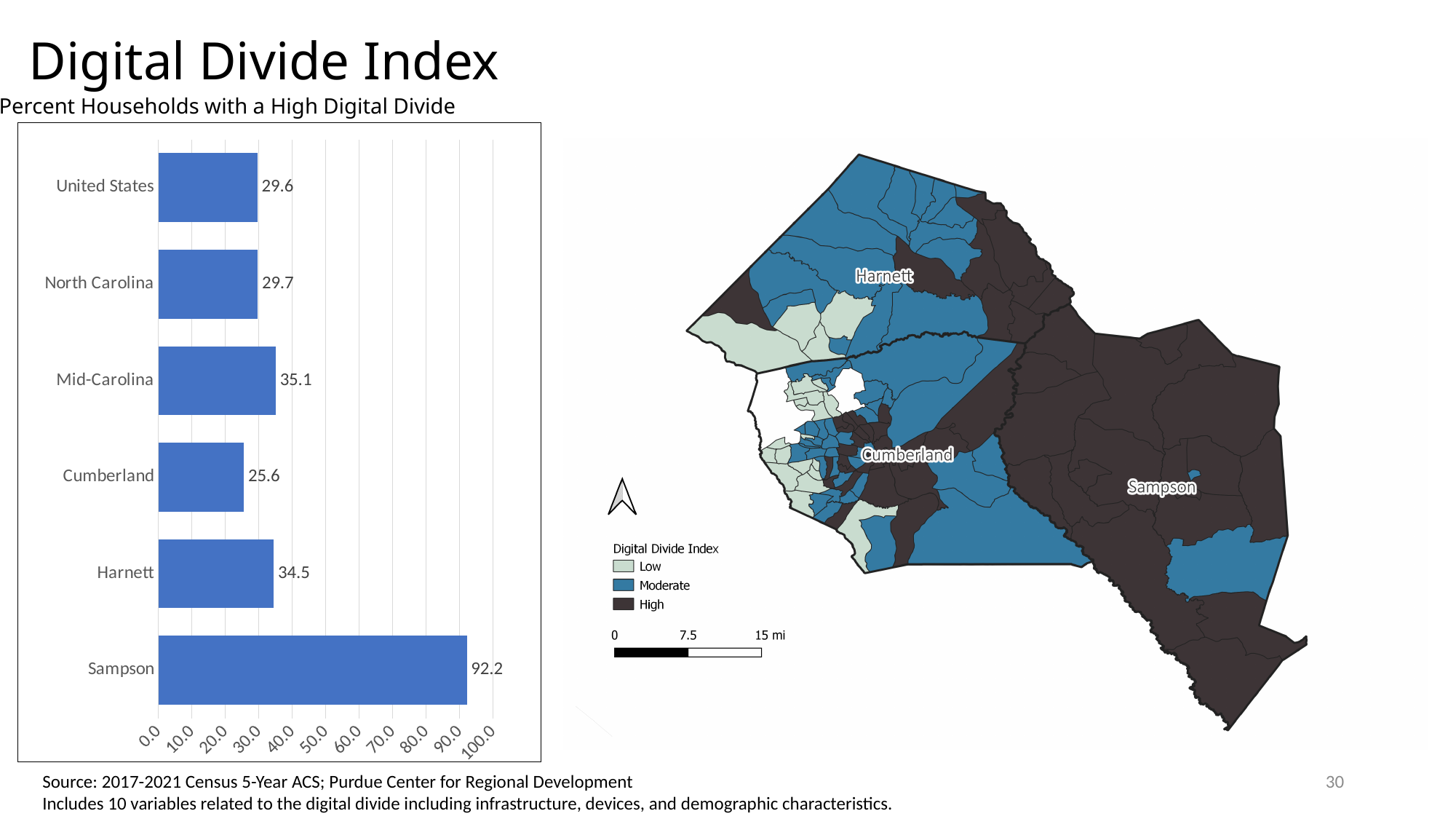
Which is larger in the bar chart, the value for Harnett or the value for Cumberland? Harnett What is the difference between the values for Sampson and Cumberland in the bar chart? 66.6 What are the three categories listed in the map legend for the Digital Divide Index? Low, Moderate, High Which category has the lowest value in the bar chart? Cumberland What is the difference between the values for North Carolina and United States in the bar chart? 0.1 What kind of chart is shown on the left of the slide? Bar chart What is the value for Mid-Carolina in the bar chart? 35.1 What is the value for Harnett in the bar chart? 34.5 Which category has the highest value in the bar chart? Sampson What is the value for Cumberland in the bar chart? 25.6 What is the value for Sampson in the Percent Households with a High Digital Divide chart? 92.2 How many categories are shown in the bar chart? 6